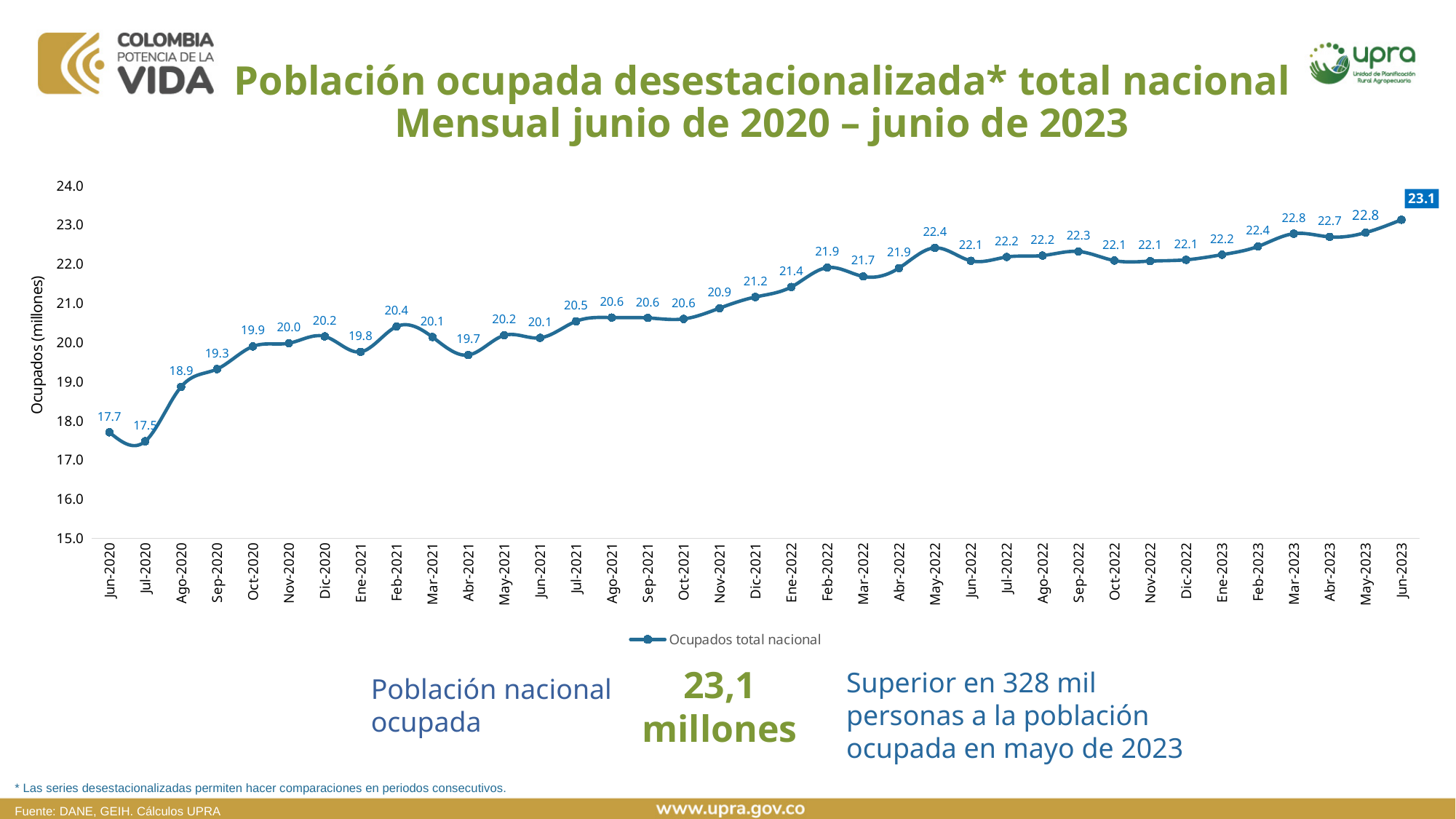
How many series does the legend list? 1 Is the value for Dic-2021 greater or less than 21.0? greater Do the values generally rise or fall from Jun-2020 to Jun-2023? rise Which is larger, the value for Feb-2021 or the value for Abr-2021? Feb-2021 Which month has the lowest value? Jul-2020 What is the value for Jun-2023? 23.1 What is the value for Jun-2020? 17.7 Which month has the highest value? Jun-2023 How many monthly data points are plotted? 37 What is the difference between the values for Jun-2023 and Jun-2020? 5.4 What is the value for May-2022? 22.4 What kind of chart is shown? line chart